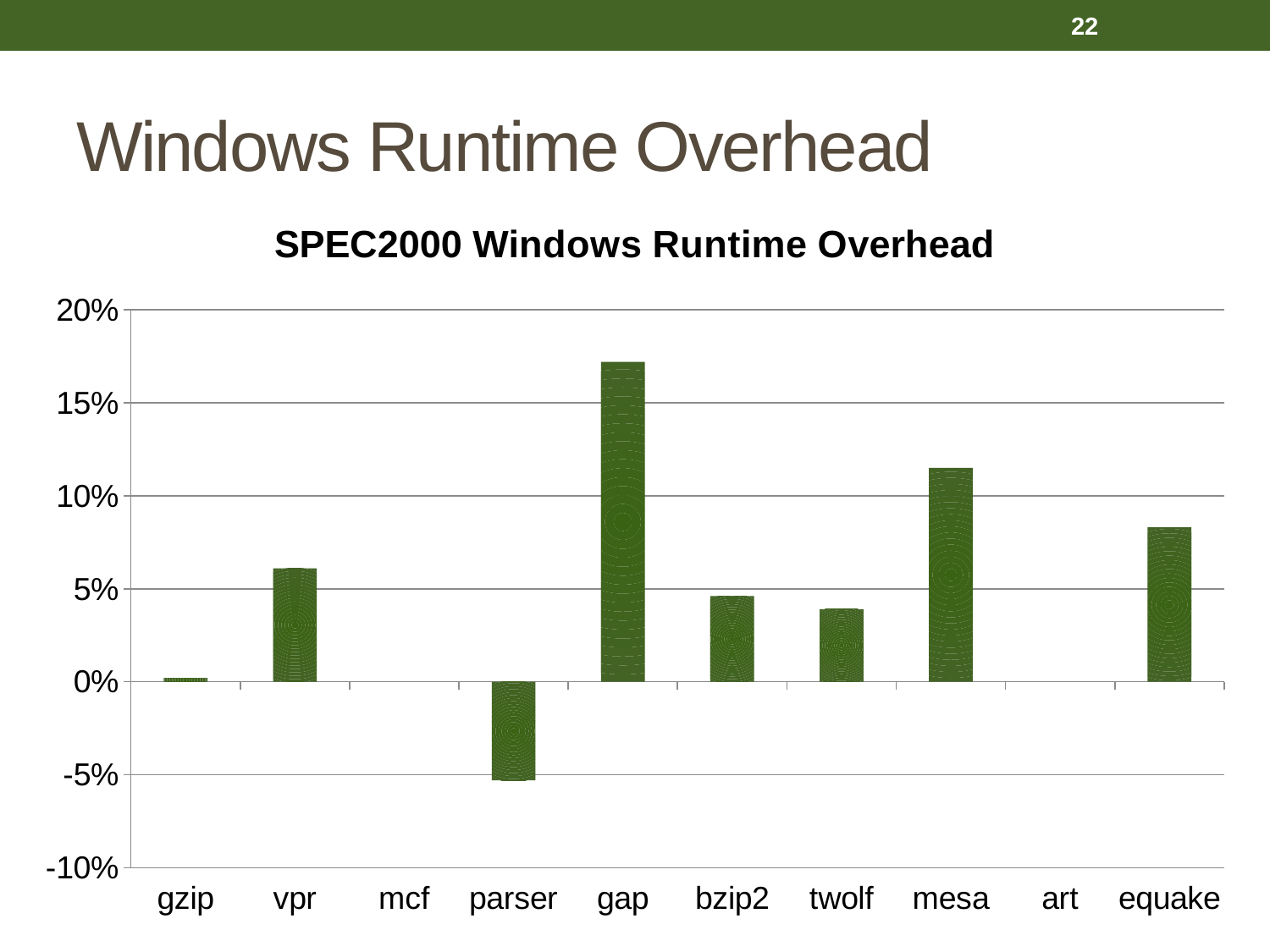
What kind of chart is shown on the slide? bar chart Which has the larger runtime overhead, vpr or twolf? vpr Is the value for twolf greater or less than 5%? less How many benchmark categories are shown on the x axis? 10 Is the value for gap greater or less than 15%? greater What is the title of the chart? SPEC2000 Windows Runtime Overhead Which has the larger runtime overhead, mesa or equake? mesa Is the value for equake greater or less than 10%? less Which benchmark has the highest runtime overhead? gap Which benchmark has the lowest runtime overhead? parser